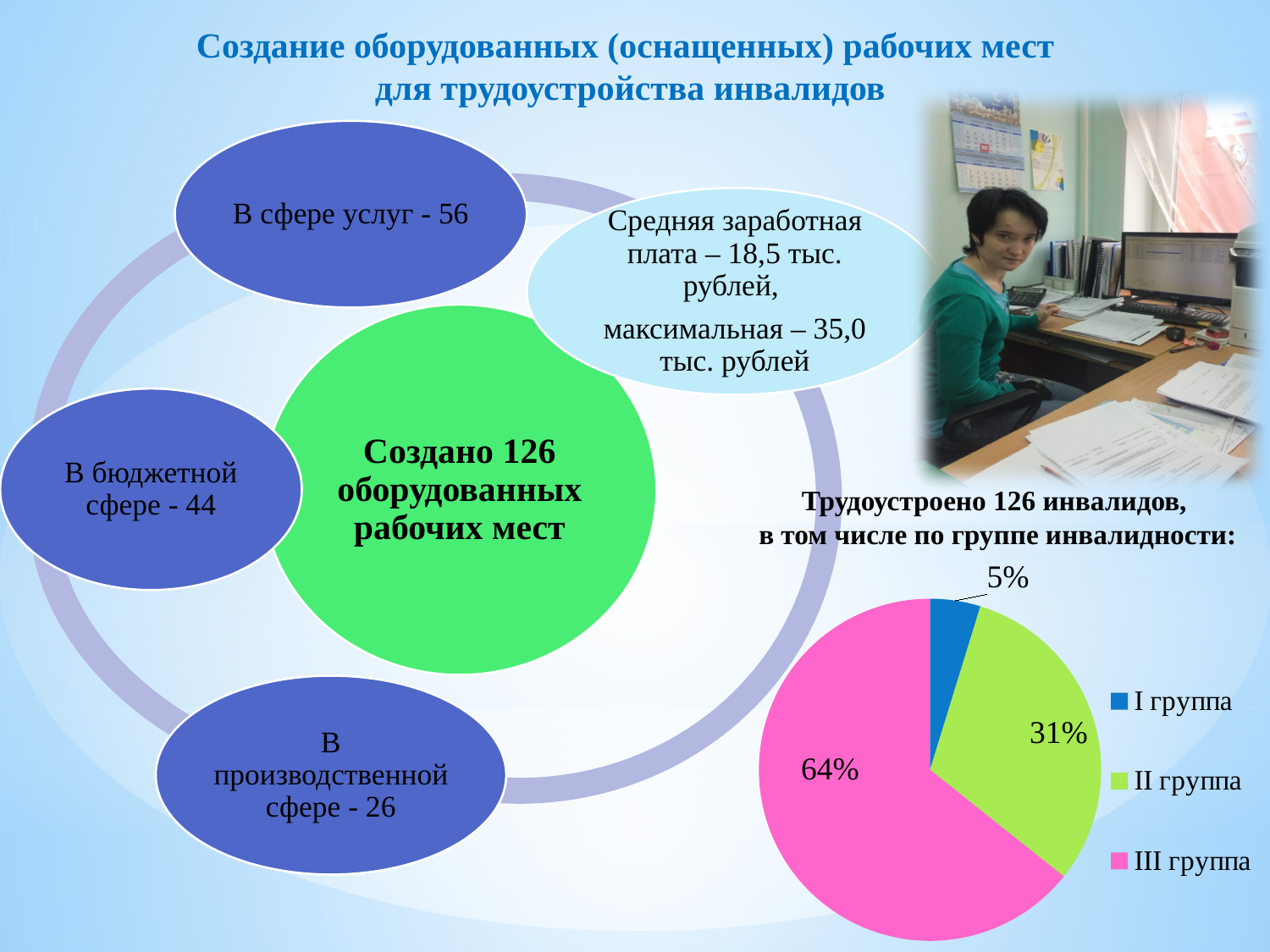
What colour is the III группа slice in the pie chart? pink Which group has the smallest slice in the pie chart? I группа What kind of chart is shown on the slide? pie chart How many entries does the legend of the pie chart list? 3 What is the difference in percentage points between III группа and II группа in the pie chart? 33 How many slices does the pie chart have? 3 Which group has the largest slice in the pie chart? III группа Which slice is larger in the pie chart, II группа or I группа? II группа What is the difference in percentage points between II группа and I группа in the pie chart? 26 What share of the pie chart does III группа have? 64% What share of the pie chart does II группа have? 31% What share of the pie chart does I группа have? 5%